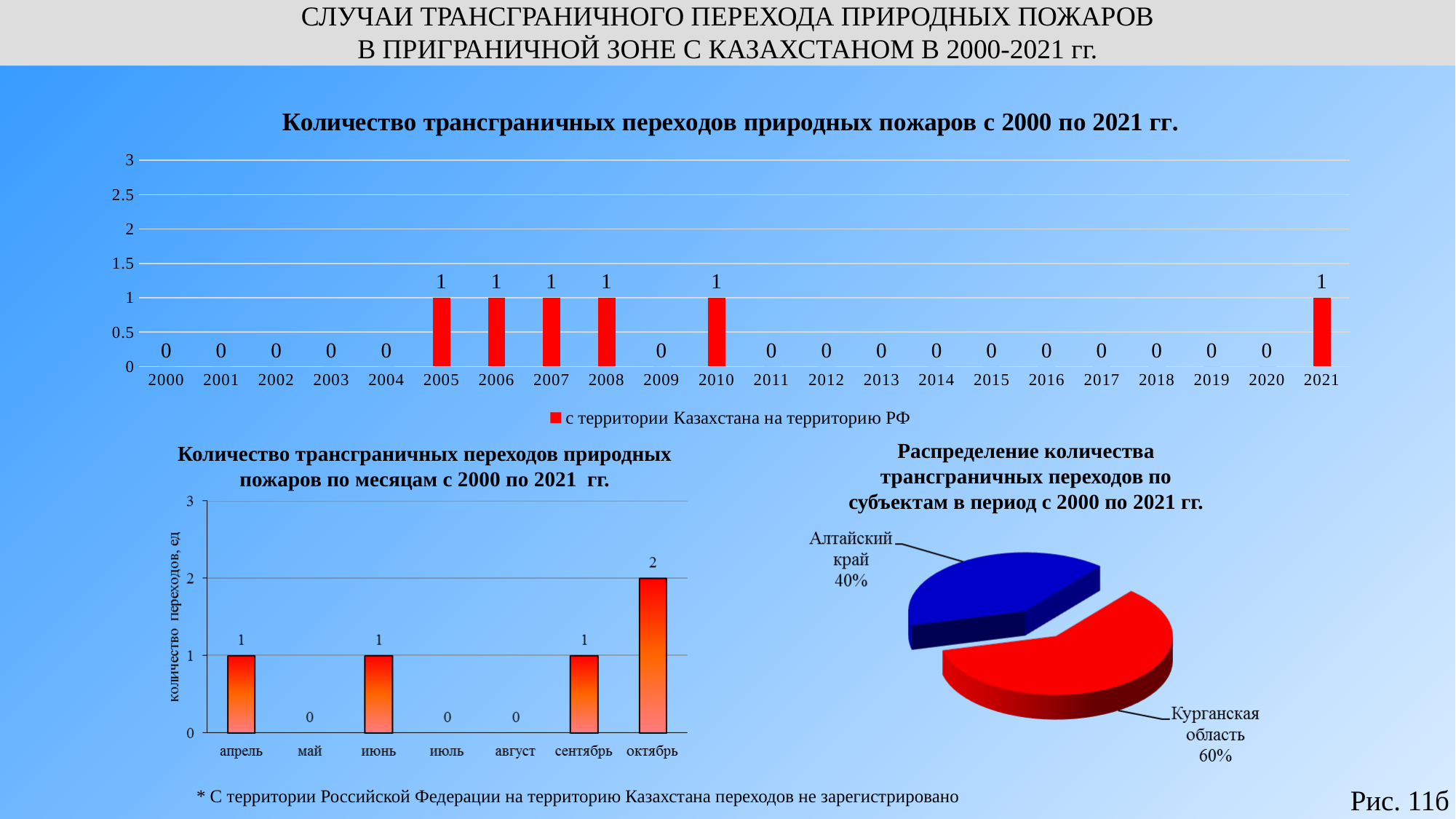
What kind of chart is the bottom-right chart 'Распределение количества трансграничных переходов по субъектам в период с 2000 по 2021 гг.'? pie chart In the bottom-left chart 'Количество трансграничных переходов природных пожаров по месяцам с 2000 по 2021 гг.', what is the value for сентябрь? 1 In the bottom-right pie chart 'Распределение количества трансграничных переходов по субъектам в период с 2000 по 2021 гг.', what share does Курганская область have? 60% In the top chart 'Количество трансграничных переходов природных пожаров с 2000 по 2021 гг.', how many series does the legend list? 1 In the top chart 'Количество трансграничных переходов природных пожаров с 2000 по 2021 гг.', how many years are shown on the x axis? 22 In the bottom-left chart 'Количество трансграничных переходов природных пожаров по месяцам с 2000 по 2021 гг.', what is the difference between октябрь and апрель? 1 In the top chart 'Количество трансграничных переходов природных пожаров с 2000 по 2021 гг.', what is the value for 2015? 0 In the bottom-left chart 'Количество трансграничных переходов природных пожаров по месяцам с 2000 по 2021 гг.', how many months are shown? 7 In the top chart 'Количество трансграничных переходов природных пожаров с 2000 по 2021 гг.', what is the legend entry? с территории Казахстана на территорию РФ In the bottom-right pie chart 'Распределение количества трансграничных переходов по субъектам в период с 2000 по 2021 гг.', which is larger, Алтайский край or Курганская область? Курганская область In the top chart 'Количество трансграничных переходов природных пожаров с 2000 по 2021 гг.', what is the value for 2010? 1 In the bottom-left chart 'Количество трансграничных переходов природных пожаров по месяцам с 2000 по 2021 гг.', which month has the highest value? октябрь